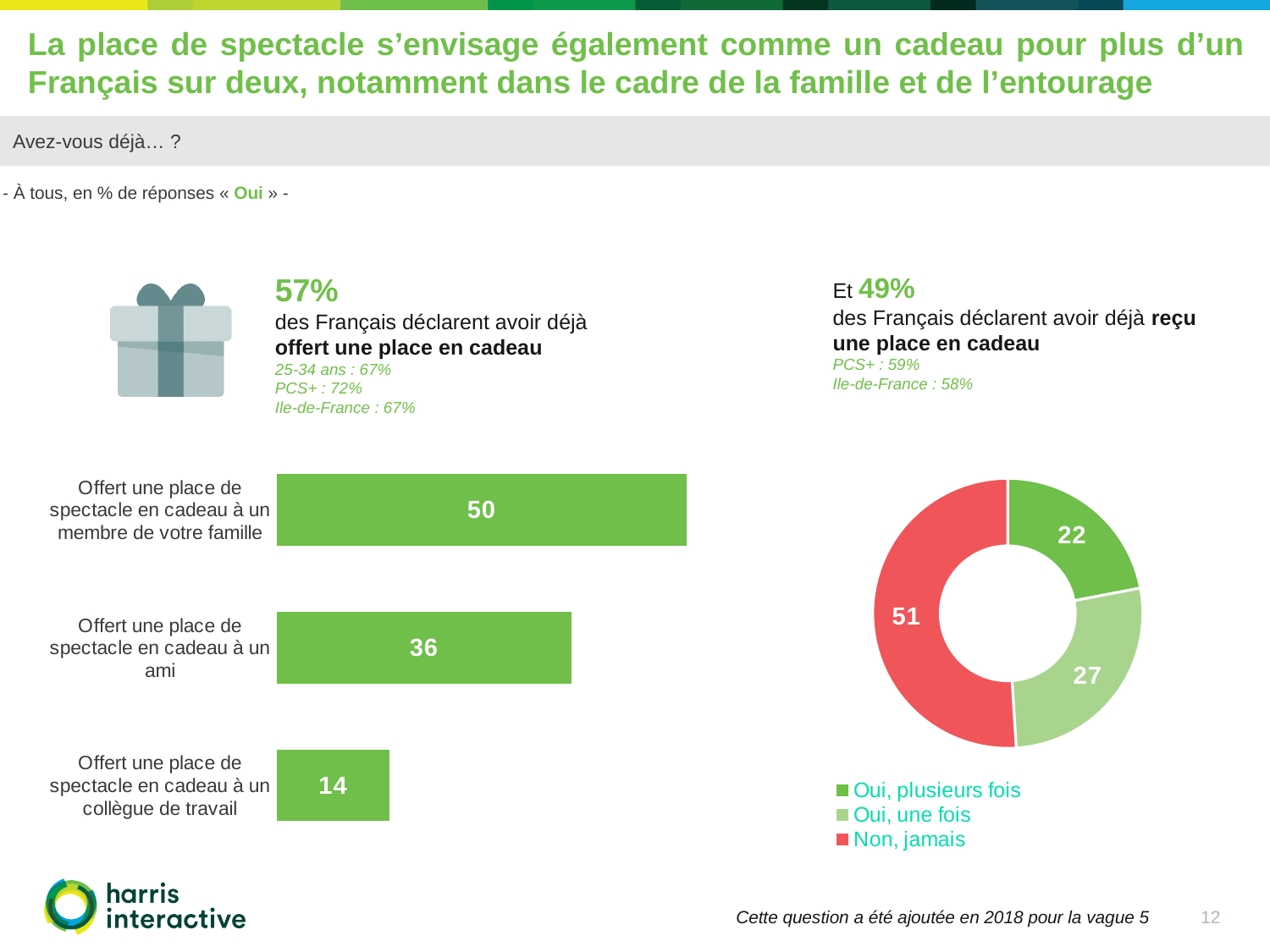
How many entries does the legend of the donut chart on the right list? 3 In the bar chart on the left, what is the value for 'Offert une place de spectacle en cadeau à un collègue de travail'? 14 In the bar chart on the left, what is the value for 'Offert une place de spectacle en cadeau à un membre de votre famille'? 50 In the bar chart on the left, which category has the highest value? Offert une place de spectacle en cadeau à un membre de votre famille In the donut chart on the right, what is the value for 'Non, jamais'? 51 In the bar chart on the left, what is the difference between the value for a member of the family and the value for a friend (ami)? 14 In the donut chart on the right, what is the value for 'Oui, plusieurs fois'? 22 In the donut chart on the right, which of 'Oui, une fois' and 'Oui, plusieurs fois' has the larger value? Oui, une fois In the bar chart on the left, which category has the lowest value? Offert une place de spectacle en cadeau à un collègue de travail In the bar chart on the left, what is the value for 'Offert une place de spectacle en cadeau à un ami'? 36 What kind of chart is the chart on the left of the slide? Bar chart In the bar chart on the left, how many categories are shown? 3